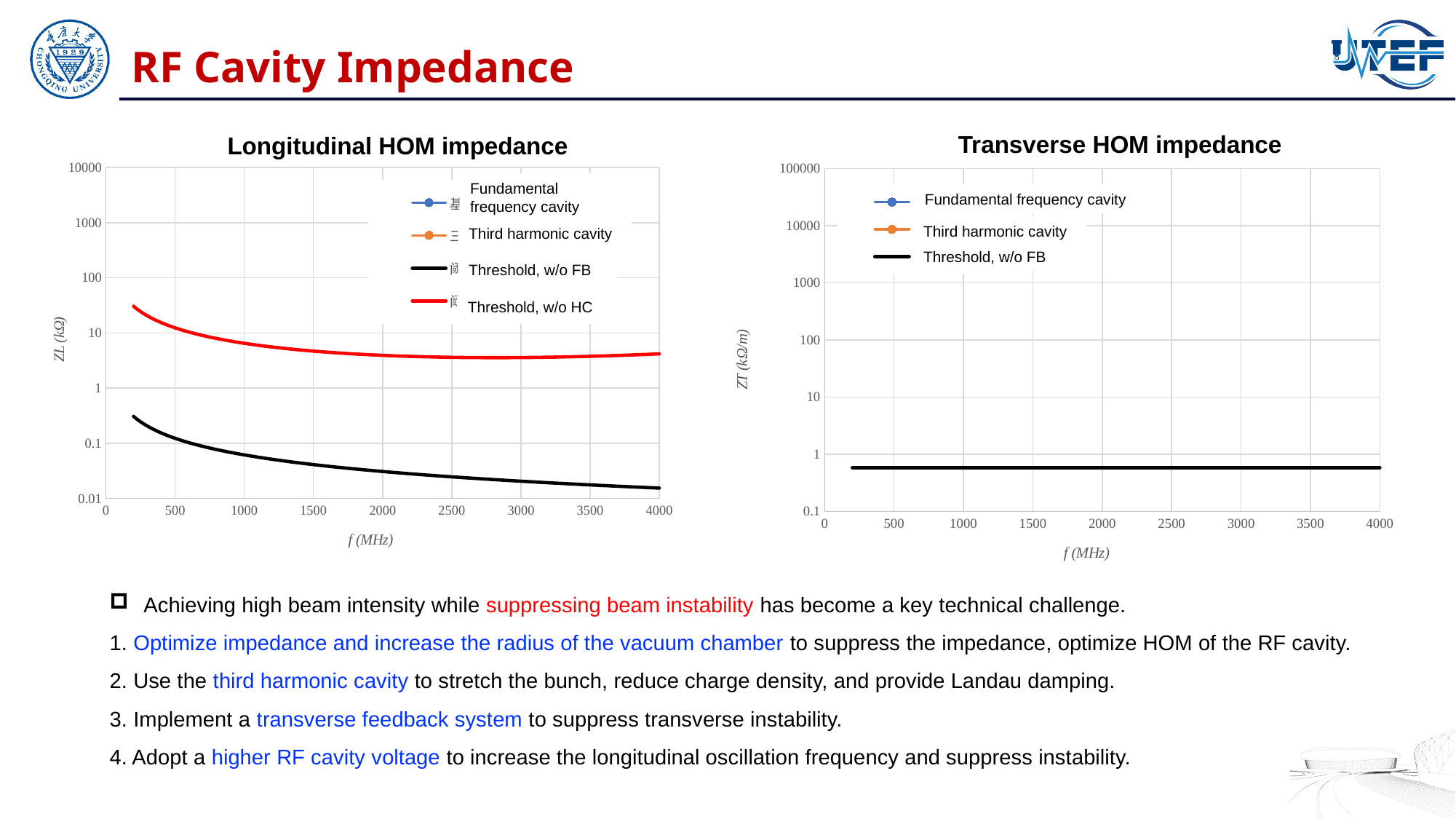
In the Longitudinal HOM impedance chart, which is larger at 2000 MHz: Threshold, w/o HC or Threshold, w/o FB? Threshold, w/o HC How many series does the legend of the Transverse HOM impedance chart list? 3 In the Longitudinal HOM impedance chart, is the Threshold, w/o HC value at 2000 MHz greater or less than 1? greater In the Transverse HOM impedance chart, is the Threshold, w/o FB value greater or less than 1? less In the Longitudinal HOM impedance chart, is the Threshold, w/o FB value at 200 MHz greater or less than 1? less How many series does the legend of the Longitudinal HOM impedance chart list? 4 What kind of chart is the Longitudinal HOM impedance chart? line chart In the Longitudinal HOM impedance chart, does the Threshold, w/o FB line rise or fall as frequency increases? fall In the Transverse HOM impedance chart, does the Threshold, w/o FB line rise, fall, or stay flat as frequency increases? stay flat What is the y-axis label of the Transverse HOM impedance chart? ZT (kΩ/m)